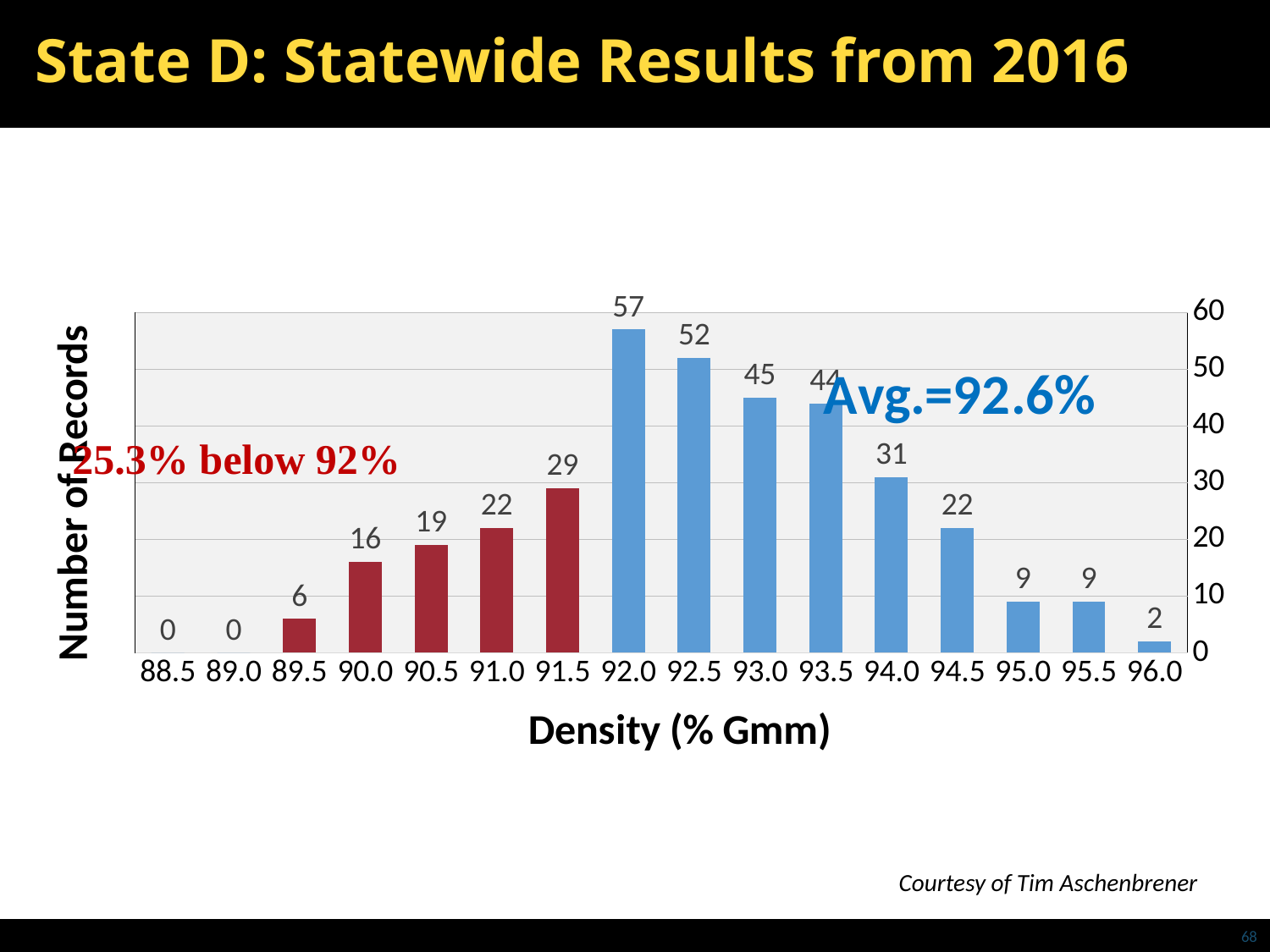
What is the number of records for density 92.0? 57 What kind of chart is shown on the slide? Bar chart Which density category has the highest number of records? 92.0 What is the difference in number of records between density 92.0 and density 92.5? 5 What is the number of records for density 96.0? 2 How many density categories are shown on the x axis? 16 Which has more records, density 94.0 or density 91.5? 94.0 Do the number of records rise or fall from density 92.0 to density 96.0? Fall What average value is annotated on the chart? Avg.=92.6% What is the difference in number of records between density 93.0 and density 91.5? 16 What is the label of the x axis? Density (% Gmm) What is the number of records for density 91.5? 29